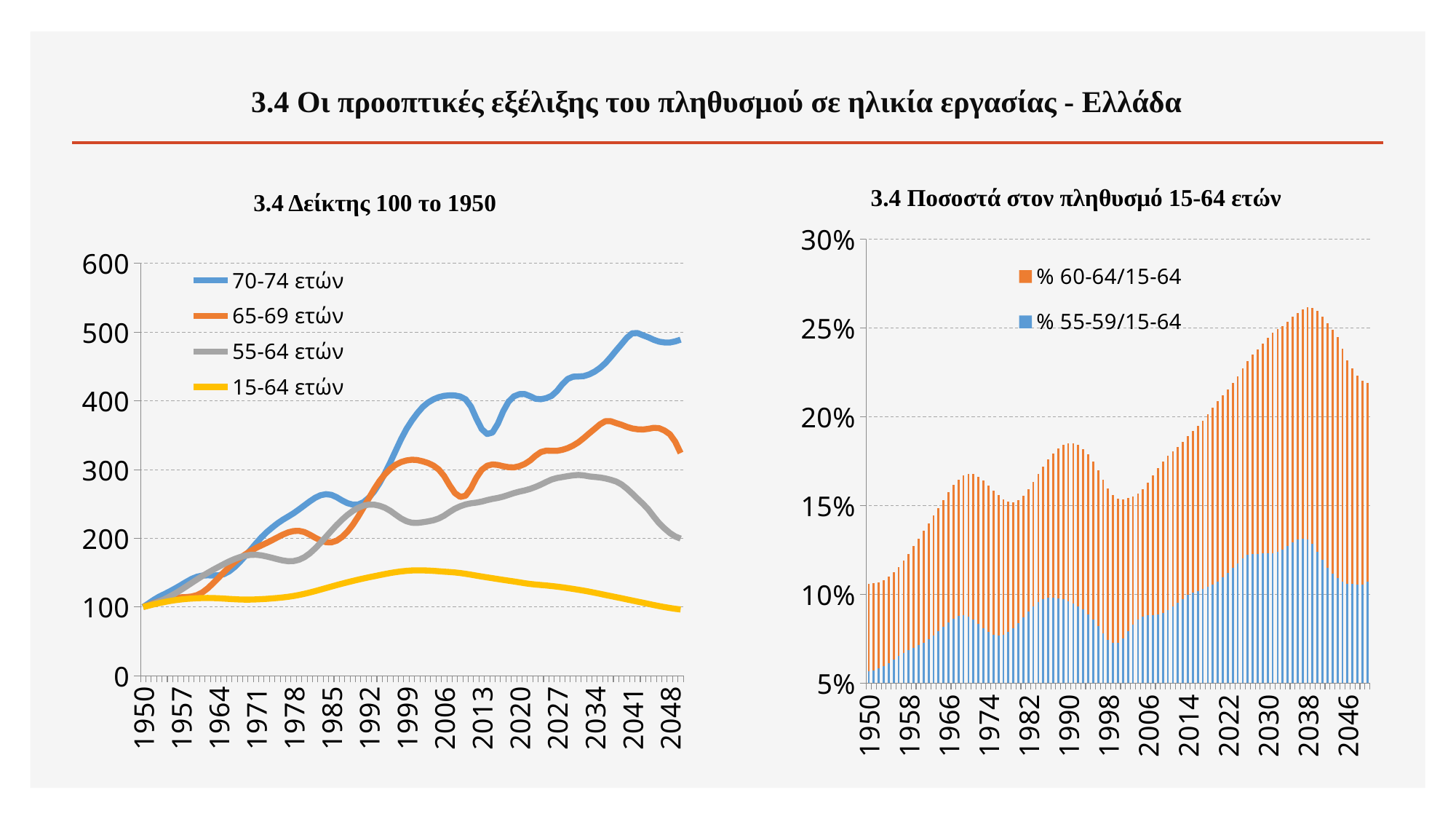
In the left chart "3.4 Δείκτης 100 το 1950", does the 70-74 ετών series overall rise or fall from 1950 to 2048? rise In the left chart "3.4 Δείκτης 100 το 1950", is the value for 15-64 ετών at 2048 greater or less than 200? less In the left chart "3.4 Δείκτης 100 το 1950", is the value for 70-74 ετών at 2048 greater or less than 400? greater How many series does the legend of the left chart "3.4 Δείκτης 100 το 1950" list? 4 What kind of chart is the right chart titled "3.4 Ποσοστά στον πληθυσμό 15-64 ετών"? bar chart What kind of chart is the left chart titled "3.4 Δείκτης 100 το 1950"? line chart How many series does the legend of the right chart "3.4 Ποσοστά στον πληθυσμό 15-64 ετών" list? 2 In the left chart "3.4 Δείκτης 100 το 1950", which series has the highest value at 2048? 70-74 ετών In the right chart "3.4 Ποσοστά στον πληθυσμό 15-64 ετών", which series is shown in orange? % 60-64/15-64 In the left chart "3.4 Δείκτης 100 το 1950", which is larger at 2048: 70-74 ετών or 65-69 ετών? 70-74 ετών In the right chart "3.4 Ποσοστά στον πληθυσμό 15-64 ετών", is the total stacked value at 2038 greater or less than 25%? greater In the left chart "3.4 Δείκτης 100 το 1950", which series has the lowest value at 2048? 15-64 ετών